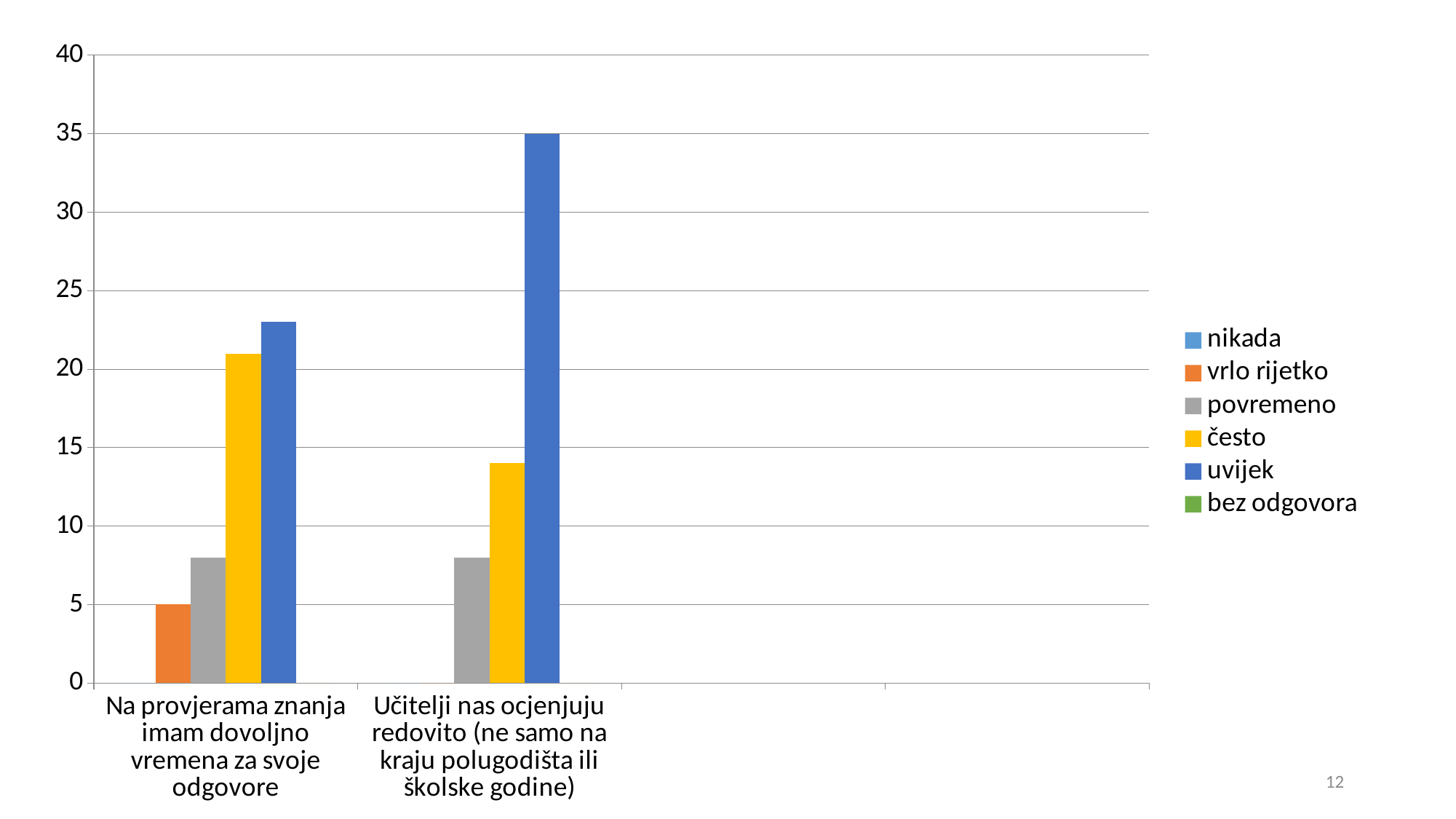
Is the value of "povremeno" for "Na provjerama znanja imam dovoljno vremena za svoje odgovore" greater or less than 10? less What kind of chart is shown on the slide? bar chart Which series has the highest value for "Učitelji nas ocjenjuju redovito (ne samo na kraju polugodišta ili školske godine)"? uvijek Which is larger: "uvijek" for "Na provjerama znanja imam dovoljno vremena za svoje odgovore" or "uvijek" for "Učitelji nas ocjenjuju redovito (ne samo na kraju polugodišta ili školske godine)"? Učitelji nas ocjenjuju redovito (ne samo na kraju polugodišta ili školske godine) What is the value of "vrlo rijetko" for "Na provjerama znanja imam dovoljno vremena za svoje odgovore"? 5 Is the value of "često" for "Na provjerama znanja imam dovoljno vremena za svoje odgovore" greater or less than 20? greater What is the value of "uvijek" for "Učitelji nas ocjenjuju redovito (ne samo na kraju polugodišta ili školske godine)"? 35 How many series does the legend list? 6 Is the value of "često" for "Učitelji nas ocjenjuju redovito (ne samo na kraju polugodišta ili školske godine)" greater or less than 15? less What colour are the "uvijek" bars? blue Which series has the lowest visible bar for "Na provjerama znanja imam dovoljno vremena za svoje odgovore"? vrlo rijetko How many categories are shown on the x axis? 2